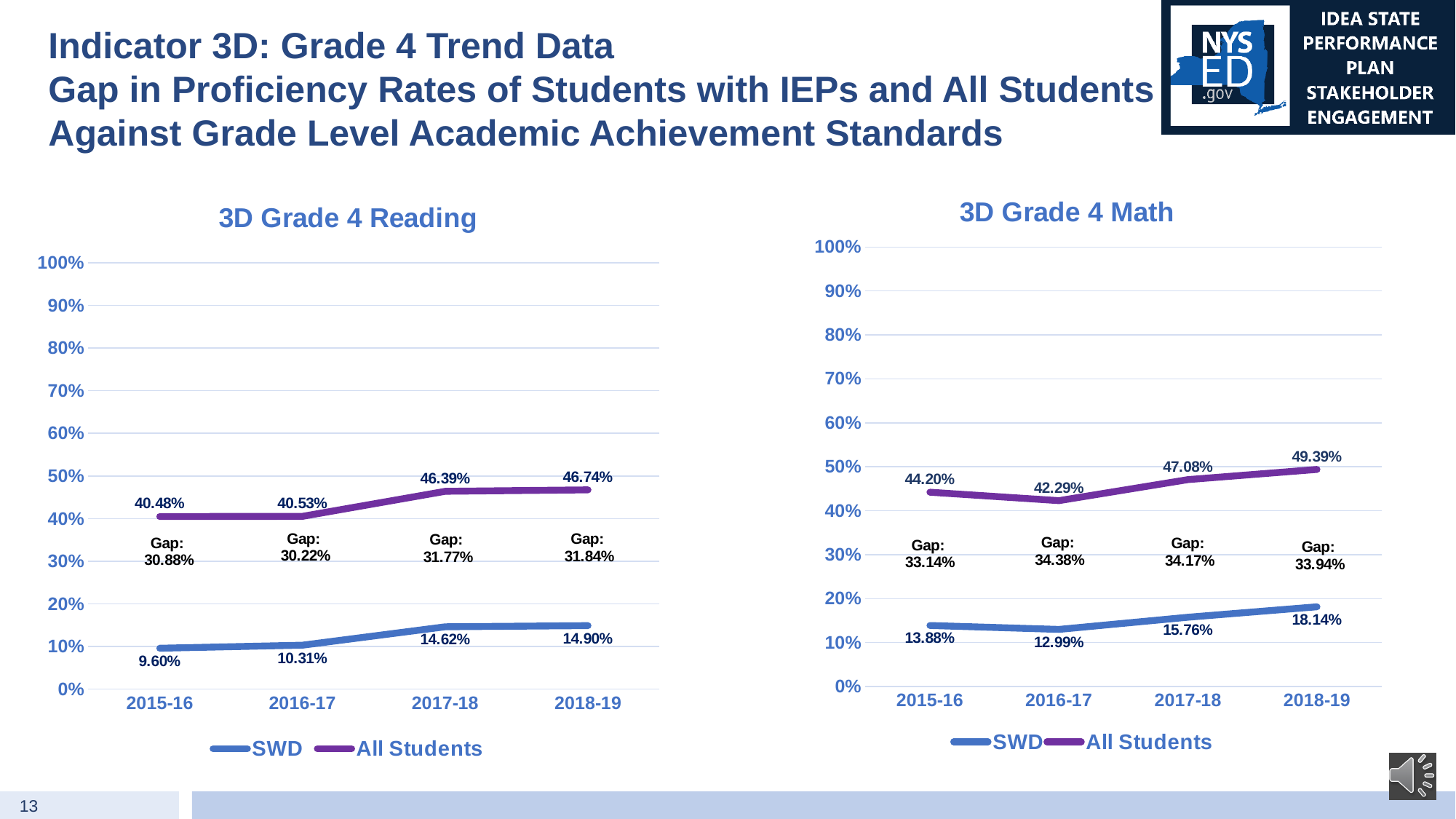
How many series does the legend of the 3D Grade 4 Math chart list? 2 In the 3D Grade 4 Reading chart, which year has the highest All Students value? 2018-19 In the 3D Grade 4 Reading chart, does the SWD series rise or fall from 2015-16 to 2018-19? rise In the 3D Grade 4 Reading chart, what is the SWD value for 2015-16? 9.60% How many years are shown on the x axis of the 3D Grade 4 Reading chart? 4 In the 3D Grade 4 Math chart, is the All Students value for 2017-18 greater or less than 50%? less What kind of chart is the 3D Grade 4 Reading chart? line chart In the 3D Grade 4 Reading chart, what is the gap shown for 2017-18? 31.77% In the 3D Grade 4 Math chart, what is the difference between the All Students and SWD values for 2016-17? 29.30% In the 3D Grade 4 Math chart, what is the All Students value for 2018-19? 49.39% In the 3D Grade 4 Math chart, which year has the lowest SWD value? 2016-17 In the 3D Grade 4 Reading chart, is the SWD value for 2018-19 larger or smaller than the SWD value for 2017-18? larger